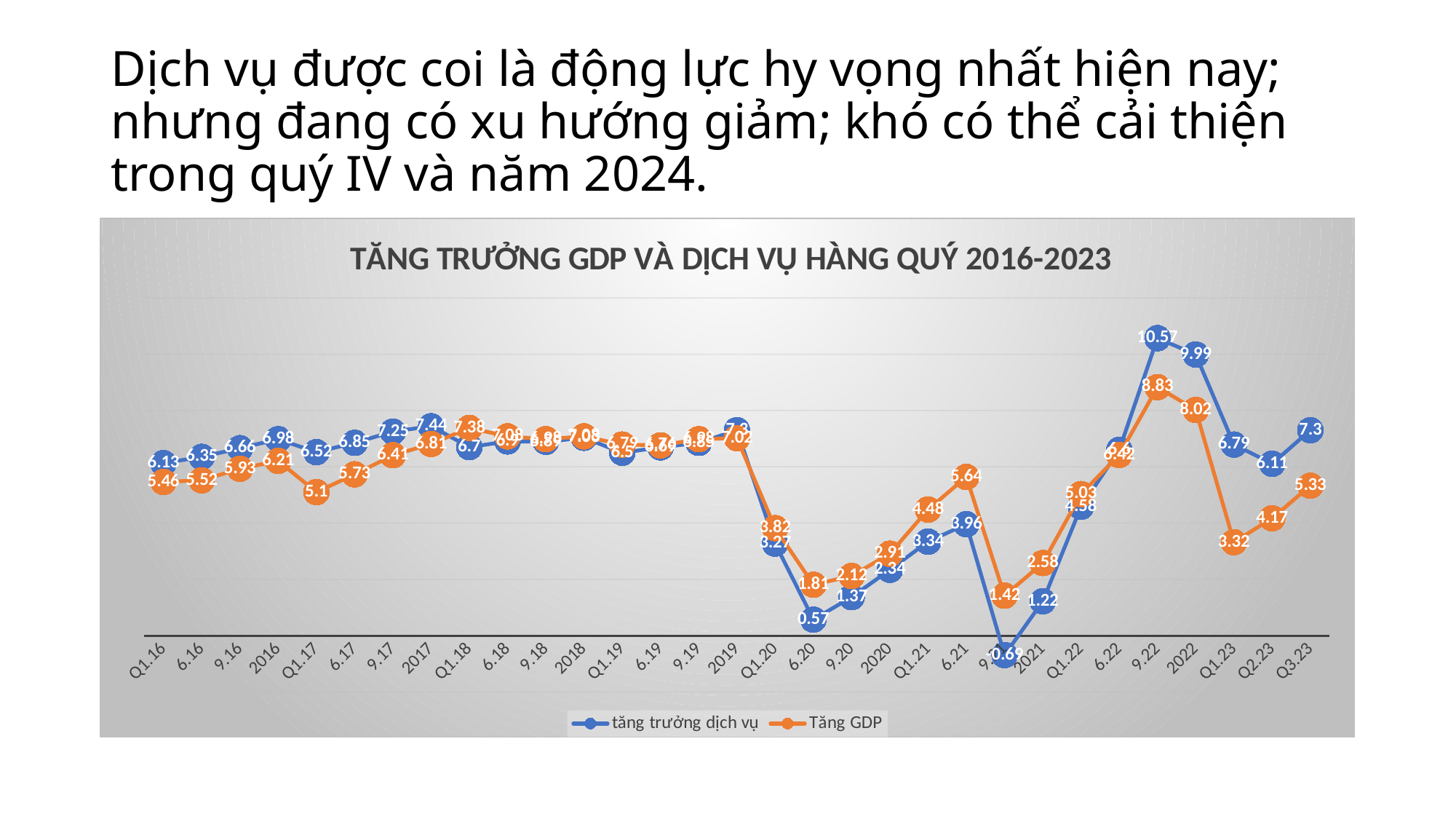
At which period does tăng trưởng dịch vụ reach its highest value? 9.22 Which is larger at Q1.23: tăng trưởng dịch vụ or Tăng GDP? tăng trưởng dịch vụ Which is larger at 6.21: tăng trưởng dịch vụ or Tăng GDP? Tăng GDP What is the value of Tăng GDP at Q1.17? 5.1 What is the difference between tăng trưởng dịch vụ and Tăng GDP at 2022? 1.97 At which period does tăng trưởng dịch vụ reach its lowest value? 9.21 At which period does Tăng GDP reach its lowest value? 9.21 How many series does the legend list? 2 What is the title of the chart? TĂNG TRƯỞNG GDP VÀ DỊCH VỤ HÀNG QUÝ 2016-2023 What is the value of tăng trưởng dịch vụ at 9.22? 10.57 What kind of chart is shown on the slide? line chart What is the value of Tăng GDP at Q3.23? 5.33